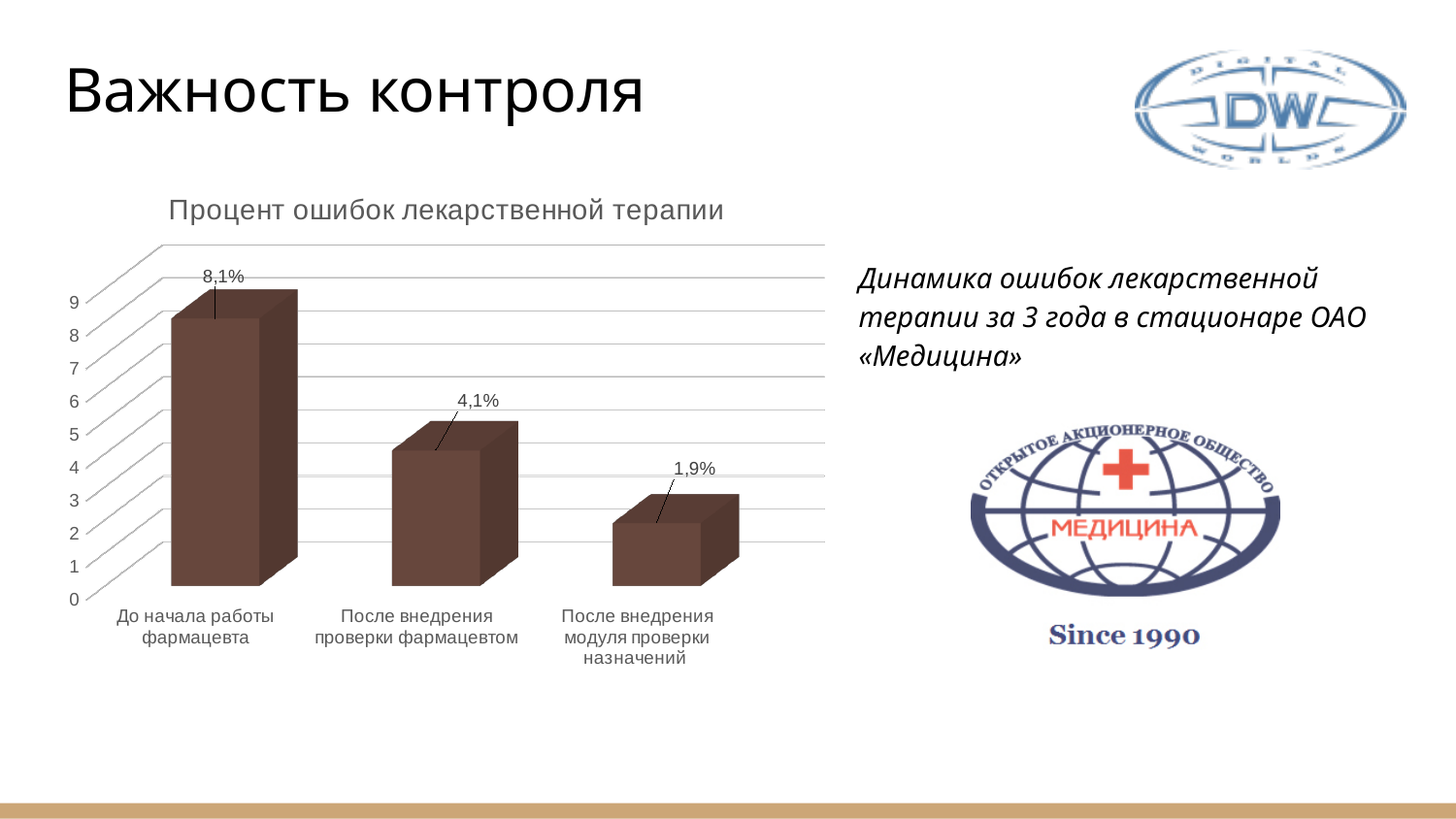
What is the value for «До начала работы фармацевта»? 8,1% Which category has the highest value? До начала работы фармацевта What kind of chart is shown on the slide? bar chart Is the value for «До начала работы фармацевта» greater or less than 5? greater Which is larger: the value for «После внедрения проверки фармацевтом» or for «После внедрения модуля проверки назначений»? После внедрения проверки фармацевтом What is the value for «После внедрения модуля проверки назначений»? 1,9% Do the values rise or fall from left to right along the x axis? fall How many categories are shown in the chart? 3 What is the value for «После внедрения проверки фармацевтом»? 4,1% What is the difference between the values for «До начала работы фармацевта» and «После внедрения проверки фармацевтом»? 4,0% Which category has the lowest value? После внедрения модуля проверки назначений What is the difference between the values for «После внедрения проверки фармацевтом» and «После внедрения модуля проверки назначений»? 2,2%